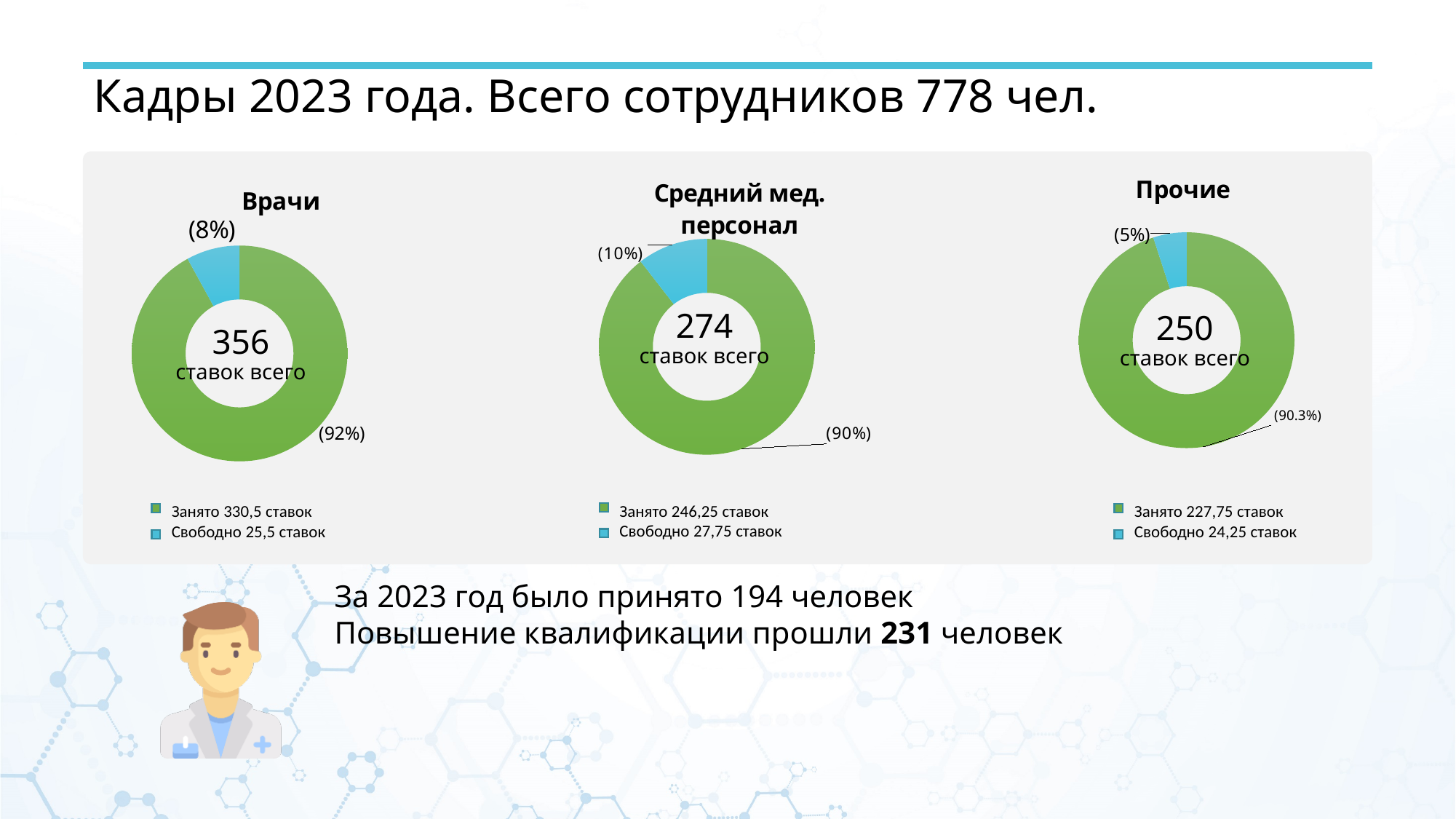
In the "Средний мед. персонал" chart, what is the value for "Занято"? 246,25 ставок In the "Прочие" chart, what share of the pie does the "Занято" slice take? 90.3% In the "Врачи" chart, what is the value for "Занято"? 330,5 ставок In the "Врачи" chart, what is the value for "Свободно"? 25,5 ставок What total number of positions is shown in the centre of the "Средний мед. персонал" chart? 274 ставок всего In the "Прочие" chart, what is the value for "Свободно"? 24,25 ставок In the "Средний мед. персонал" chart, what share of the pie does the "Свободно" slice take? 10% In the "Врачи" chart, which slice is larger, "Занято" or "Свободно"? Занято In the "Прочие" chart, which category has the smallest slice? Свободно What kind of chart is the "Средний мед. персонал" chart? Donut (pie) chart How many entries does the legend of the "Прочие" chart list? 2 In the "Врачи" chart, what share of the pie does the "Свободно" slice take? 8%